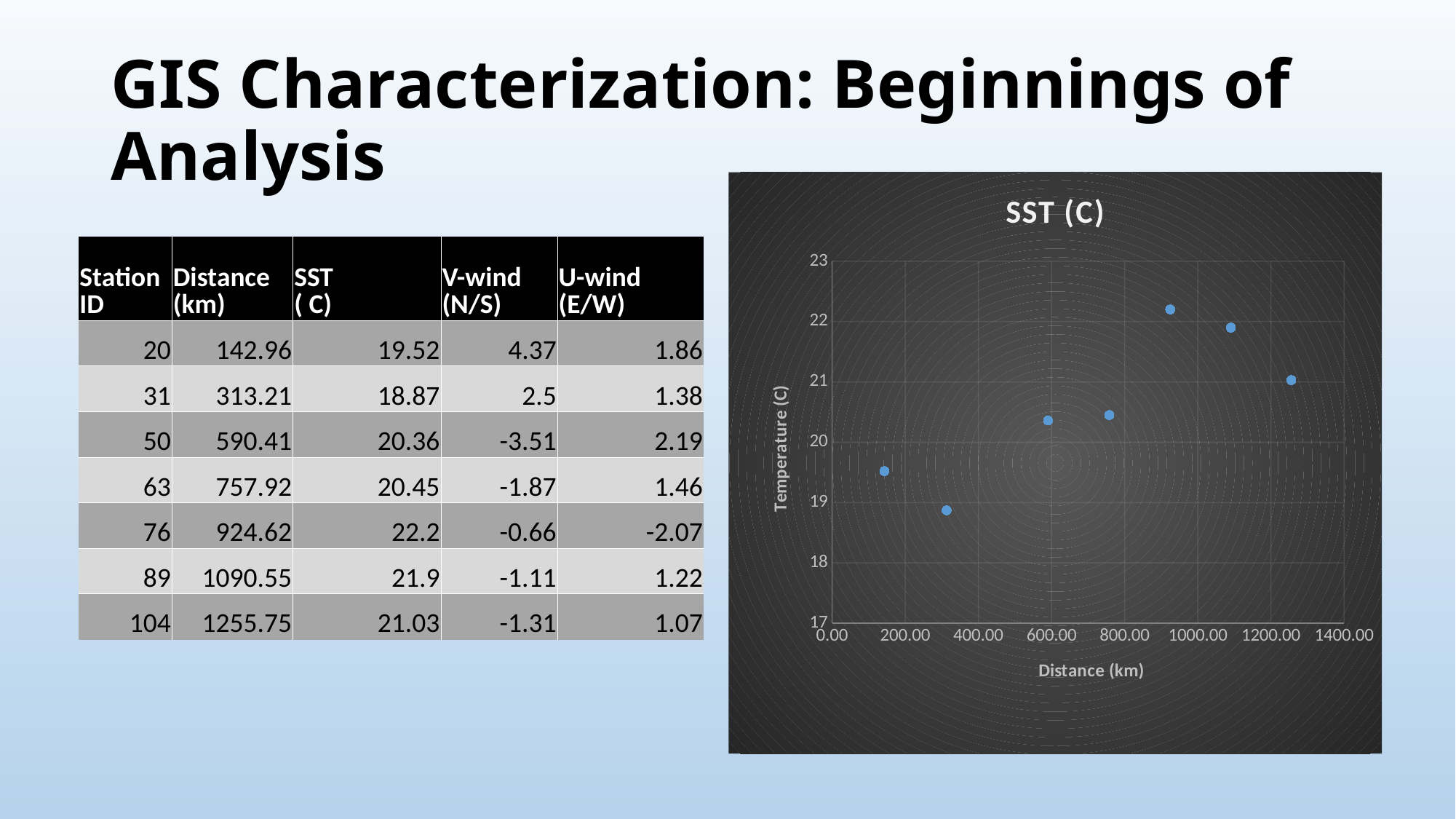
What is the title of the vertical axis on the SST (C) chart? Temperature (C) On the SST (C) chart, does the temperature rise or fall as distance increases from 313.21 km to 924.62 km? rise How many data points are plotted on the SST (C) chart? 7 On the SST (C) chart, which has the higher temperature: the point at 142.96 km or the point at 313.21 km? 142.96 km On the SST (C) chart, at which distance is the temperature lowest? 313.21 km On the SST (C) chart, is the temperature at a distance of 142.96 km greater or less than 20? less On the SST (C) chart, is the temperature at a distance of 924.62 km greater or less than 21? greater On the SST (C) chart, is the temperature at a distance of 1255.75 km greater or less than 22? less What kind of chart is the SST (C) chart? scatter chart On the SST (C) chart, at which distance is the temperature highest? 924.62 km What is the SST value plotted at a distance of 590.41 km? 20.36 What is the difference between the highest SST (22.2) and the lowest SST (18.87) shown on the slide? 3.33